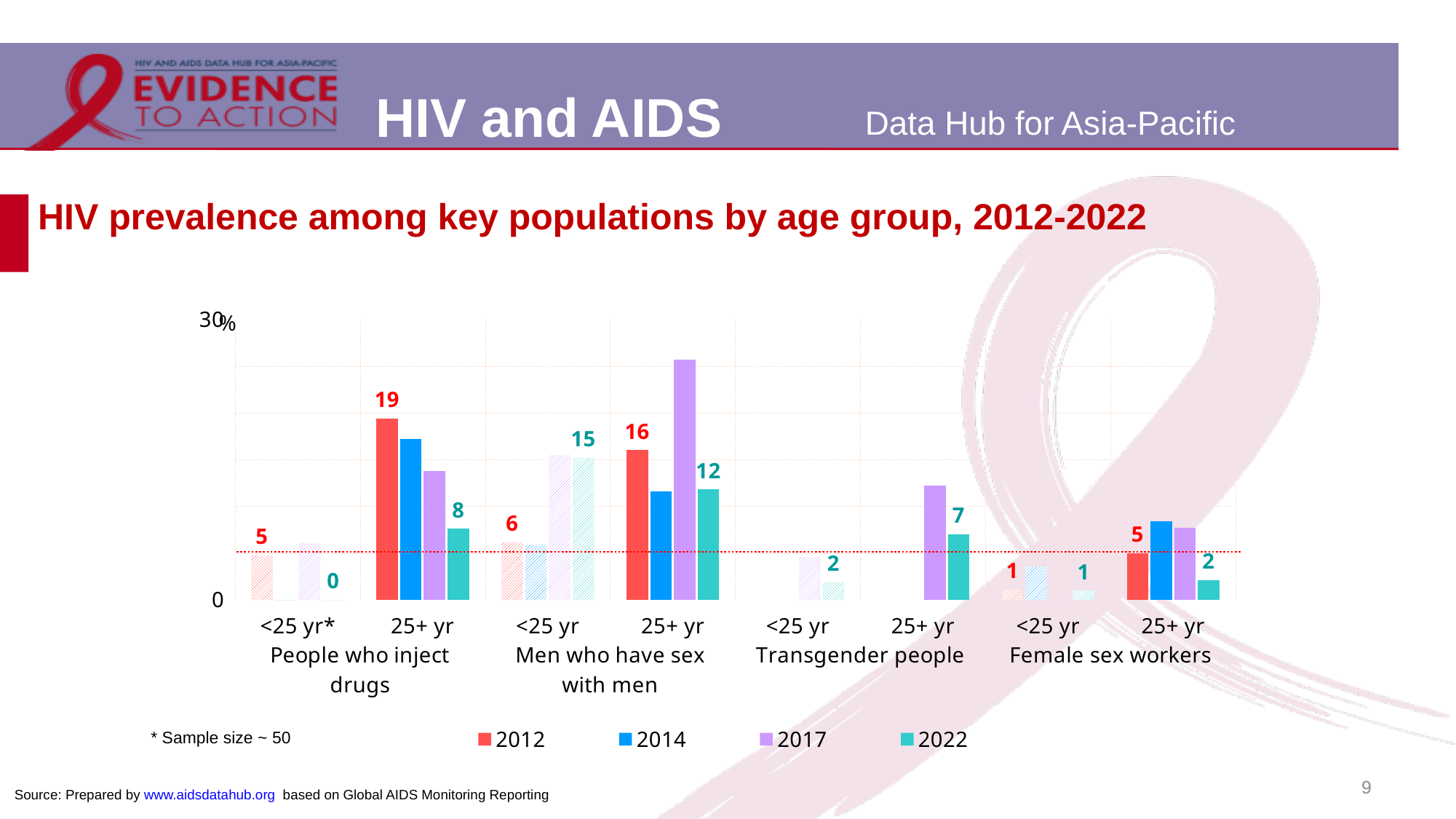
Which category has the lowest 2022 value? <25 yr, People who inject drugs Which category has the highest 2012 value? 25+ yr, People who inject drugs How many series does the legend list? 4 By how much did HIV prevalence among men who have sex with men aged <25 yr rise from 2012 to 2022? 9 For men who have sex with men aged 25+ yr, which year has the higher value, 2012 or 2022? 2012 What kind of chart is shown on the slide? Bar chart What is the 2022 HIV prevalence for men who have sex with men aged <25 yr? 15 What is the 2012 HIV prevalence for people who inject drugs aged 25+ yr? 19 What is the 2022 HIV prevalence for transgender people aged 25+ yr? 7 What is the 2022 HIV prevalence for people who inject drugs aged <25 yr? 0 By how much did HIV prevalence among people who inject drugs aged 25+ yr fall from 2012 to 2022? 11 How many age-group categories are shown along the x axis? 8